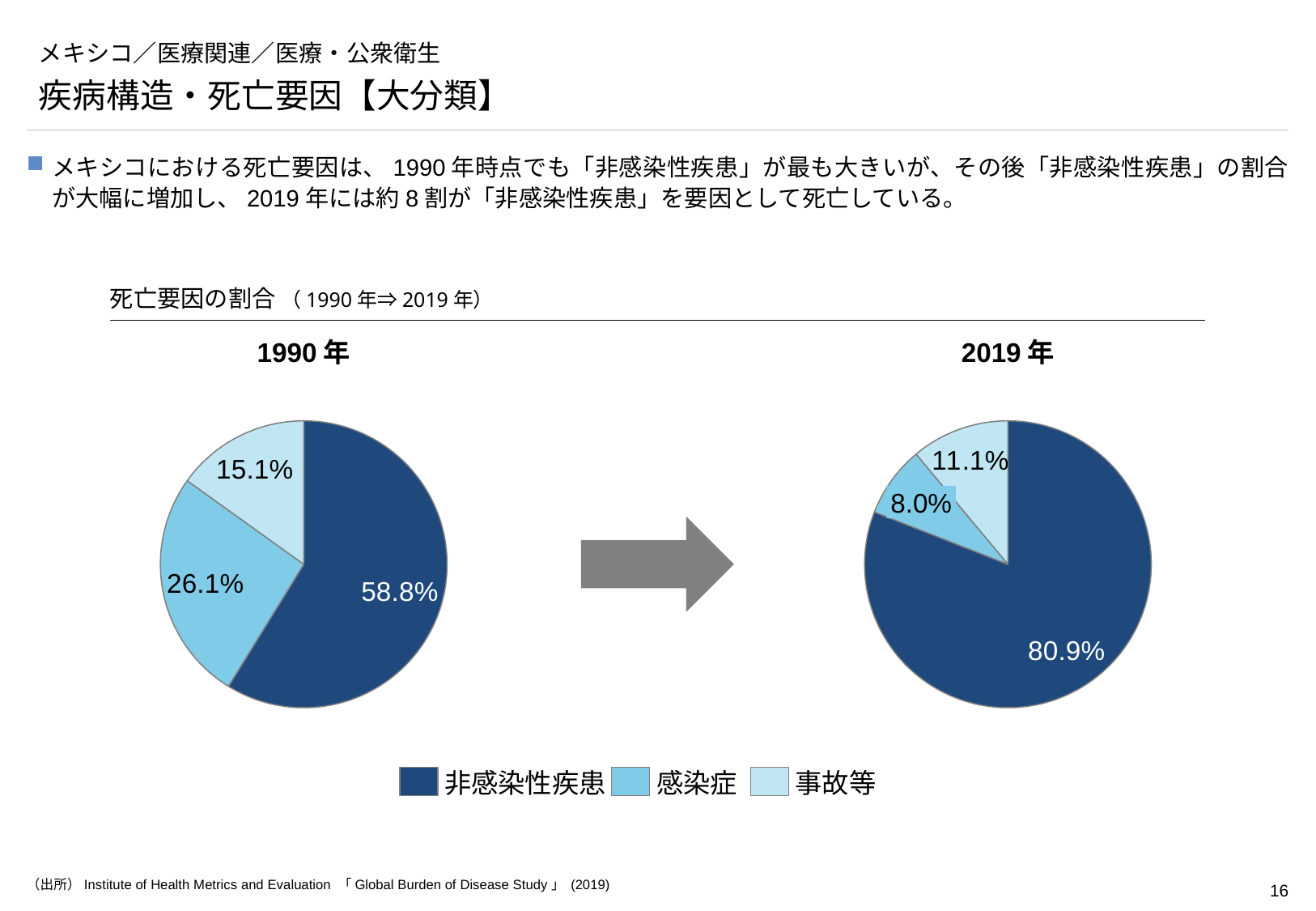
In the 1990年 pie chart, which category has the largest share? 非感染性疾患 In the 2019年 pie chart, which category has the smallest share? 感染症 In the 2019年 pie chart, what share is shown for 非感染性疾患? 80.9% In the 1990年 pie chart, which is larger, the share for 感染症 or the share for 事故等? 感染症 In the 1990年 pie chart, what share is shown for 非感染性疾患? 58.8% By how many percentage points did the share of 非感染性疾患 increase from the 1990年 chart to the 2019年 chart? 22.1 In the 1990年 pie chart, what share is shown for 事故等? 15.1% How many categories does the shared legend below the pie charts list? 3 In the 1990年 pie chart, what share is shown for 感染症? 26.1% What type of chart is used to show the 死亡要因の割合 for 1990年 and 2019年? Pie chart In the 2019年 pie chart, what share is shown for 事故等? 11.1% In the 2019年 pie chart, what share is shown for 感染症? 8.0%